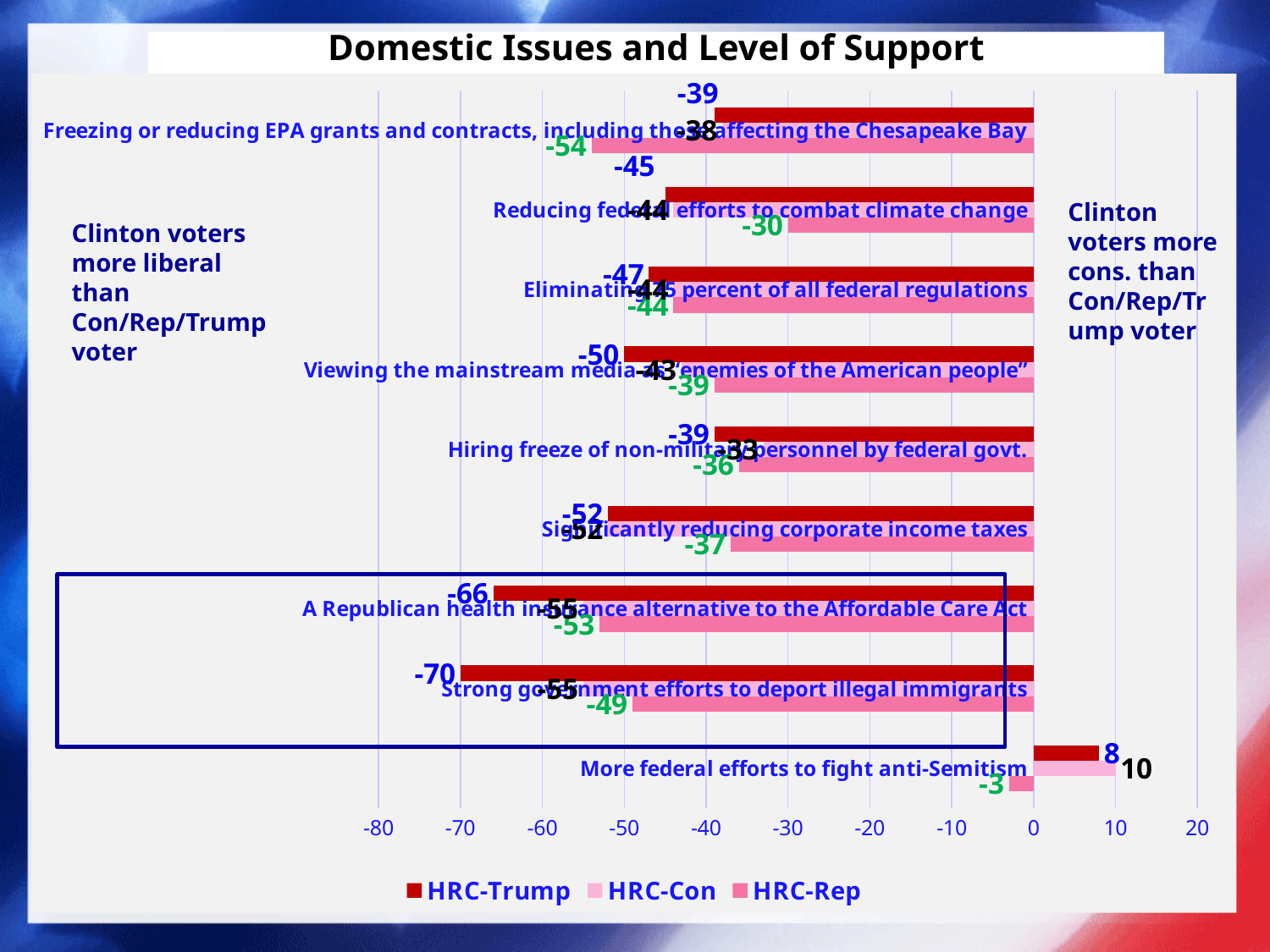
What kind of chart is shown on the slide? Bar chart Which category has the lowest HRC-Trump value? Strong government efforts to deport illegal immigrants What is the difference between the HRC-Trump value (-70) and the HRC-Rep value (-49) for "Strong government efforts to deport illegal immigrants"? 21 What is the title of the chart? Domestic Issues and Level of Support How many categories (issues) are shown on the chart? 9 For "Reducing federal efforts to combat climate change", which is larger: the HRC-Trump value or the HRC-Rep value? HRC-Rep What is the HRC-Trump value for "Strong government efforts to deport illegal immigrants"? -70 What is the HRC-Rep value for "Freezing or reducing EPA grants and contracts, including those affecting the Chesapeake Bay"? -54 What is the HRC-Con value for "More federal efforts to fight anti-Semitism"? 10 How many series does the legend list? 3 Which category has the highest HRC-Trump value? More federal efforts to fight anti-Semitism What is the HRC-Trump value for "A Republican health insurance alternative to the Affordable Care Act"? -66